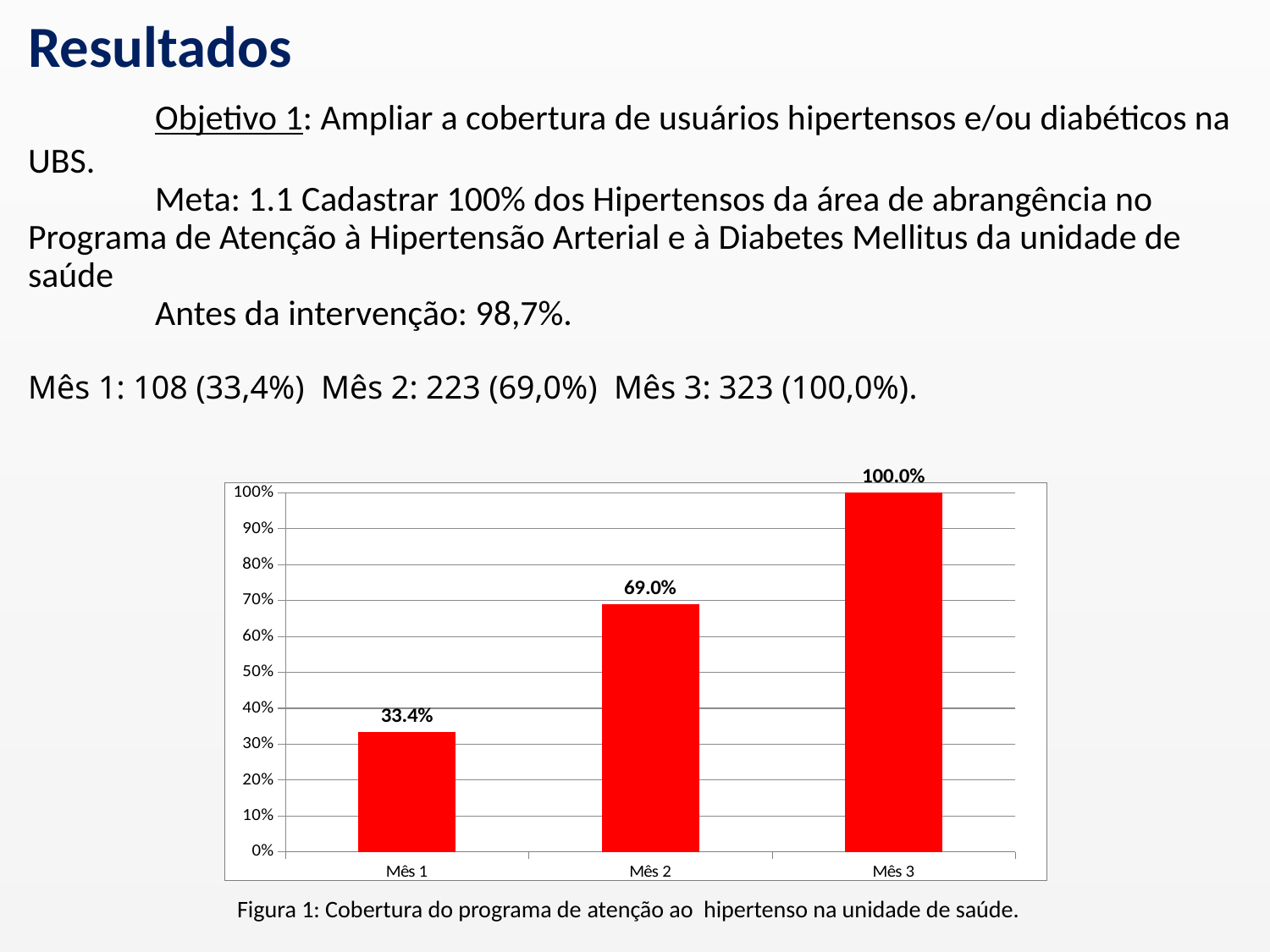
What is the difference between the values for Mês 3 and Mês 1? 66.6% What is the value for Mês 3 in the chart? 100.0% Which is larger, the value for Mês 2 or the value for Mês 1? Mês 2 Is the value for Mês 2 greater or less than 60%? greater What kind of chart is shown on the slide? bar chart What is the value for Mês 1 in the chart? 33.4% What is the difference between the values for Mês 2 and Mês 1? 35.6% Do the values rise or fall from Mês 1 to Mês 3? rise How many months are shown on the x axis of the chart? 3 Which month has the lowest value in the chart? Mês 1 What is the value for Mês 2 in the chart? 69.0% Which month has the highest value in the chart? Mês 3